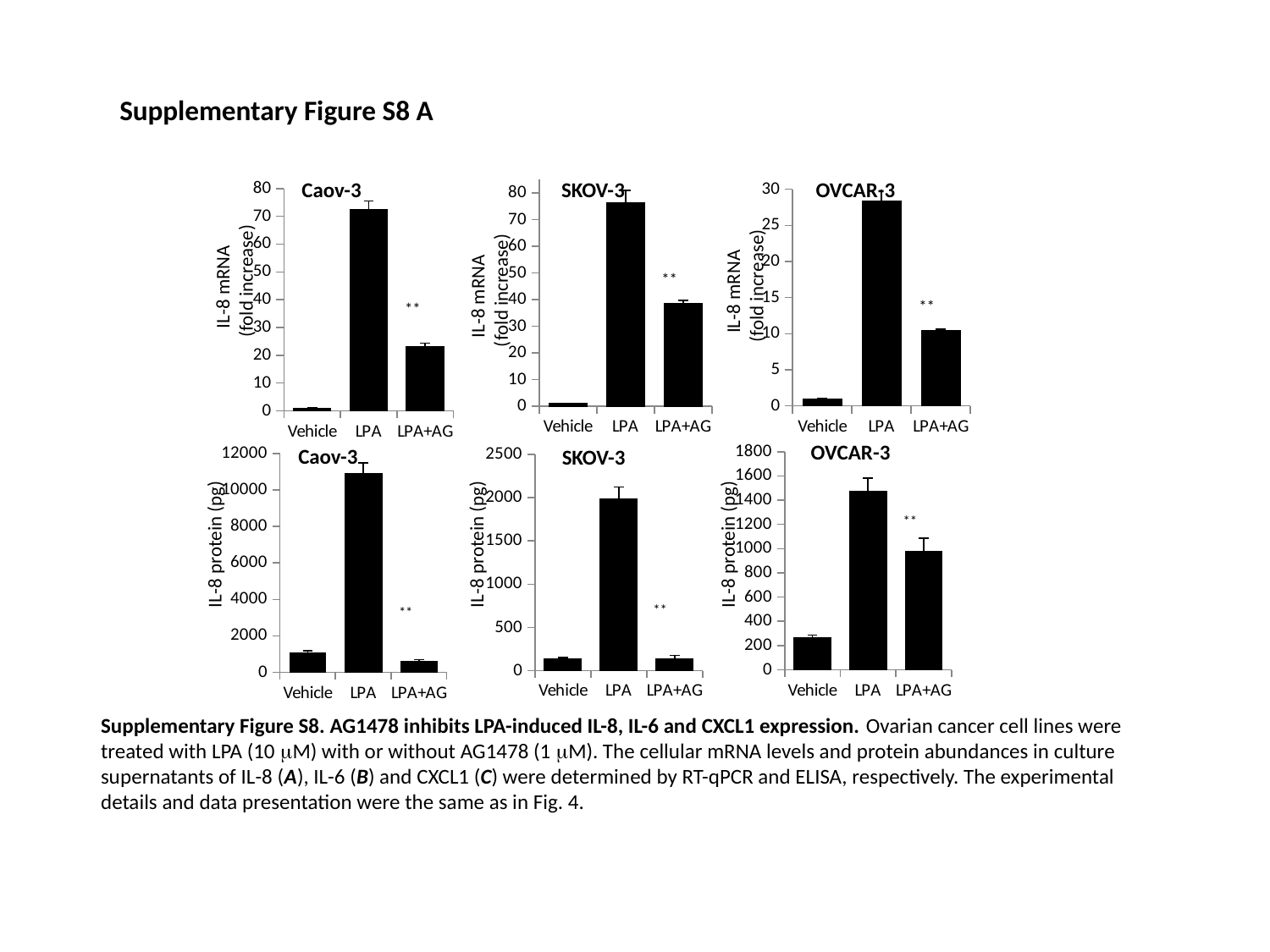
In the top-right OVCAR-3 IL-8 mRNA chart, which treatment has the highest value? LPA In the bottom-left Caov-3 IL-8 protein chart, is the value for LPA greater or less than 10000? greater In the top-middle SKOV-3 IL-8 mRNA chart, is the value for LPA+AG greater or less than 30? greater In the top-left Caov-3 IL-8 mRNA chart, which treatment has the highest value? LPA In the top-left Caov-3 IL-8 mRNA chart, is the value for LPA+AG greater or less than 30? less In the bottom-right OVCAR-3 IL-8 protein chart, which is larger, the value for LPA or the value for LPA+AG? LPA In the bottom-left Caov-3 IL-8 protein chart, how many treatment categories are shown on the x axis? 3 What is the y-axis label of the bottom-right OVCAR-3 chart? IL-8 protein (pg) In the top-left Caov-3 IL-8 mRNA chart, what kind of chart is shown? bar chart